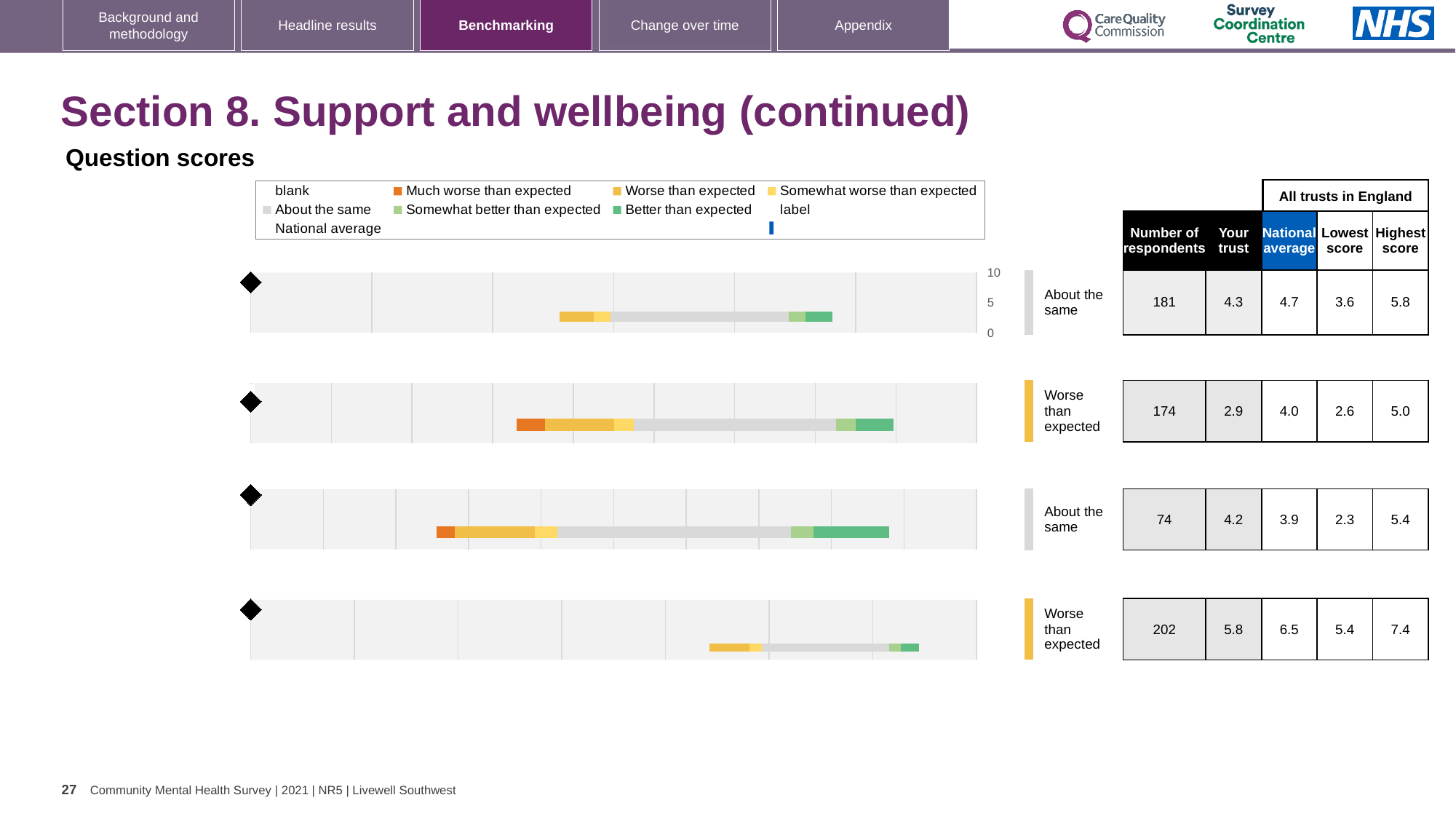
What is the highest tick value on the vertical axis of the top chart? 10 For the top chart, what is the 'Your trust' score shown in the table? 4.3 For the top chart, what is the difference between the highest score and the lowest score in the table? 2.2 For the second chart from the top, how many respondents are shown in the table? 174 For the bottom chart, what is the national average shown in the table? 6.5 Which chart has the highest 'Your trust' score in the table? the bottom chart How many of the four charts are rated 'Worse than expected'? 2 How many question-score charts are shown on the slide? 4 What benchmark rating is given for the second chart from the top? Worse than expected What kind of chart is used for the question scores on this slide? bar chart In the legend, what colour represents 'Much worse than expected'? orange For the third chart from the top, which is larger: the 'Your trust' score or the national average? Your trust